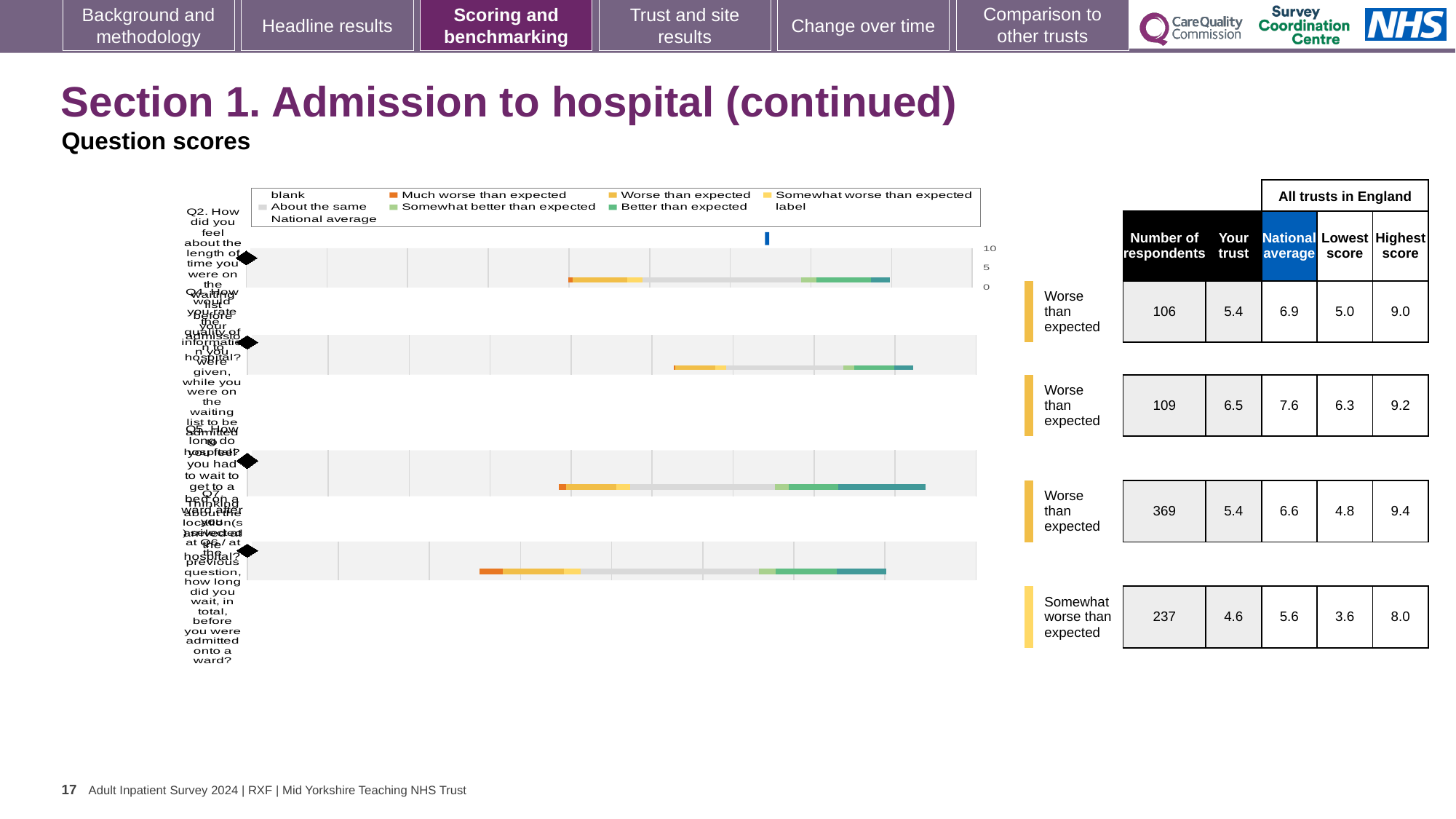
How many question rows (bars) does the chart on the left show? 4 Which row of the table has the highest 'Your trust' score? the second row (6.5) In the first row of the table, which is larger: the 'Your trust' score or the national average? the national average What kind of chart is shown on the left of the slide? bar chart In the table, what is the national average for the row with 369 respondents? 6.6 In the third row of the table, what is the difference between the highest score (9.4) and the lowest score (4.8)? 4.6 Which row of the table has the lowest 'Your trust' score? the fourth row (4.6) What is the highest score among all trusts in England for the fourth row (237 respondents)? 8.0 What benchmark category is shown for the fourth row of the table? Somewhat worse than expected How many entries does the chart's legend list? 9 In the second row of the table, how much higher is the national average (7.6) than the 'Your trust' score (6.5)? 1.1 In the table, what is the 'Your trust' score for the first row (106 respondents)? 5.4